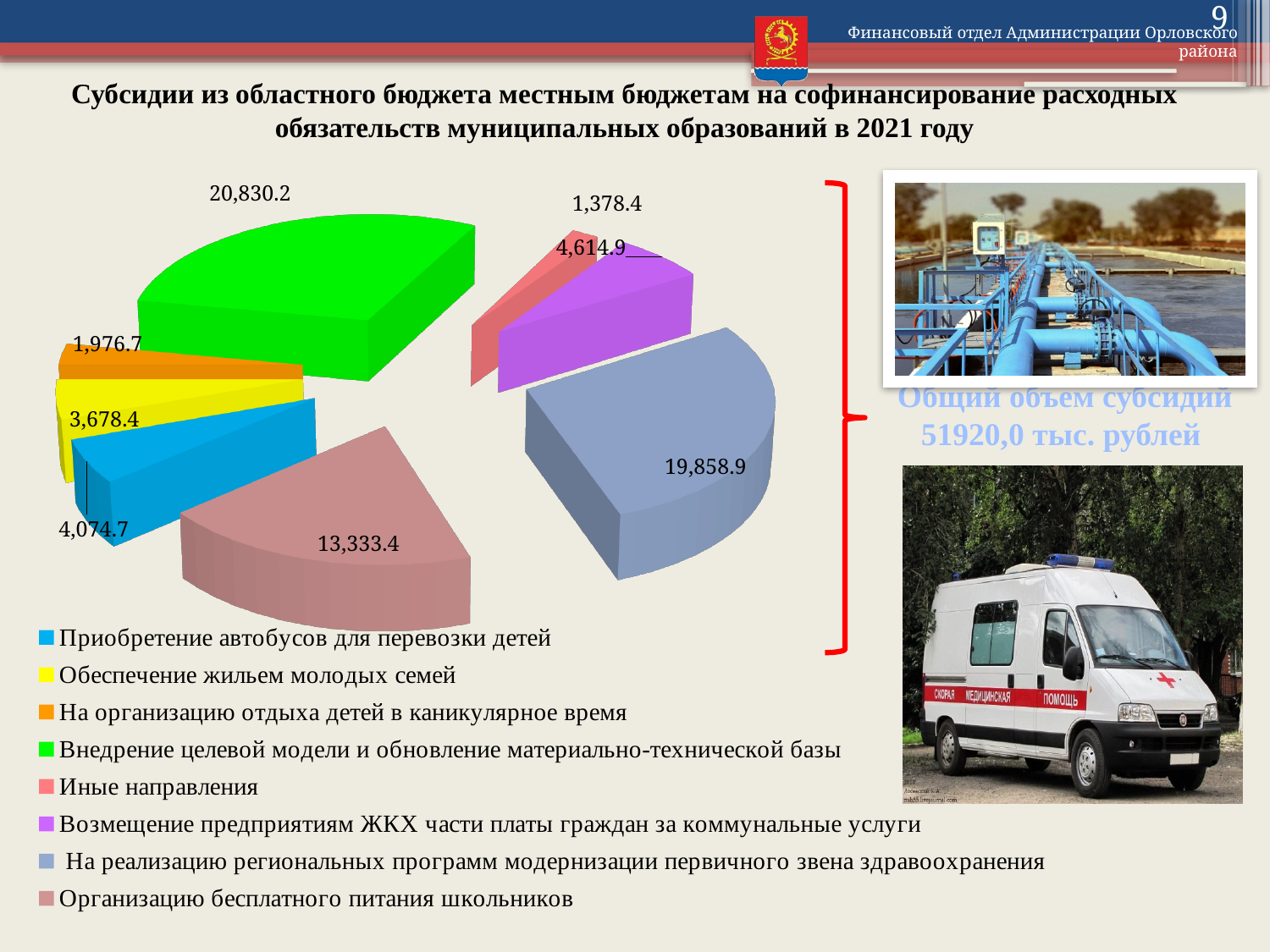
Which category has the largest slice of the pie? Внедрение целевой модели и обновление материально-технической базы What is the value for «Внедрение целевой модели и обновление материально-технической базы»? 20,830.2 What is the value for «Организацию бесплатного питания школьников»? 13,333.4 What is the value for «На реализацию региональных программ модернизации первичного звена здравоохранения»? 19,858.9 What kind of chart is shown on the slide? pie chart What is the difference between the values for «Внедрение целевой модели и обновление материально-технической базы» and «На реализацию региональных программ модернизации первичного звена здравоохранения»? 971.3 Which category has the smallest slice of the pie? Иные направления Which is larger: the value for «Обеспечение жильем молодых семей» or for «Возмещение предприятиям ЖКХ части платы граждан за коммунальные услуги»? Возмещение предприятиям ЖКХ части платы граждан за коммунальные услуги How many slices does the pie chart have? 8 What is the value for «Иные направления»? 1,378.4 What is the value for «Приобретение автобусов для перевозки детей»? 4,074.7 What colour is the slice for «Обеспечение жильем молодых семей»? yellow